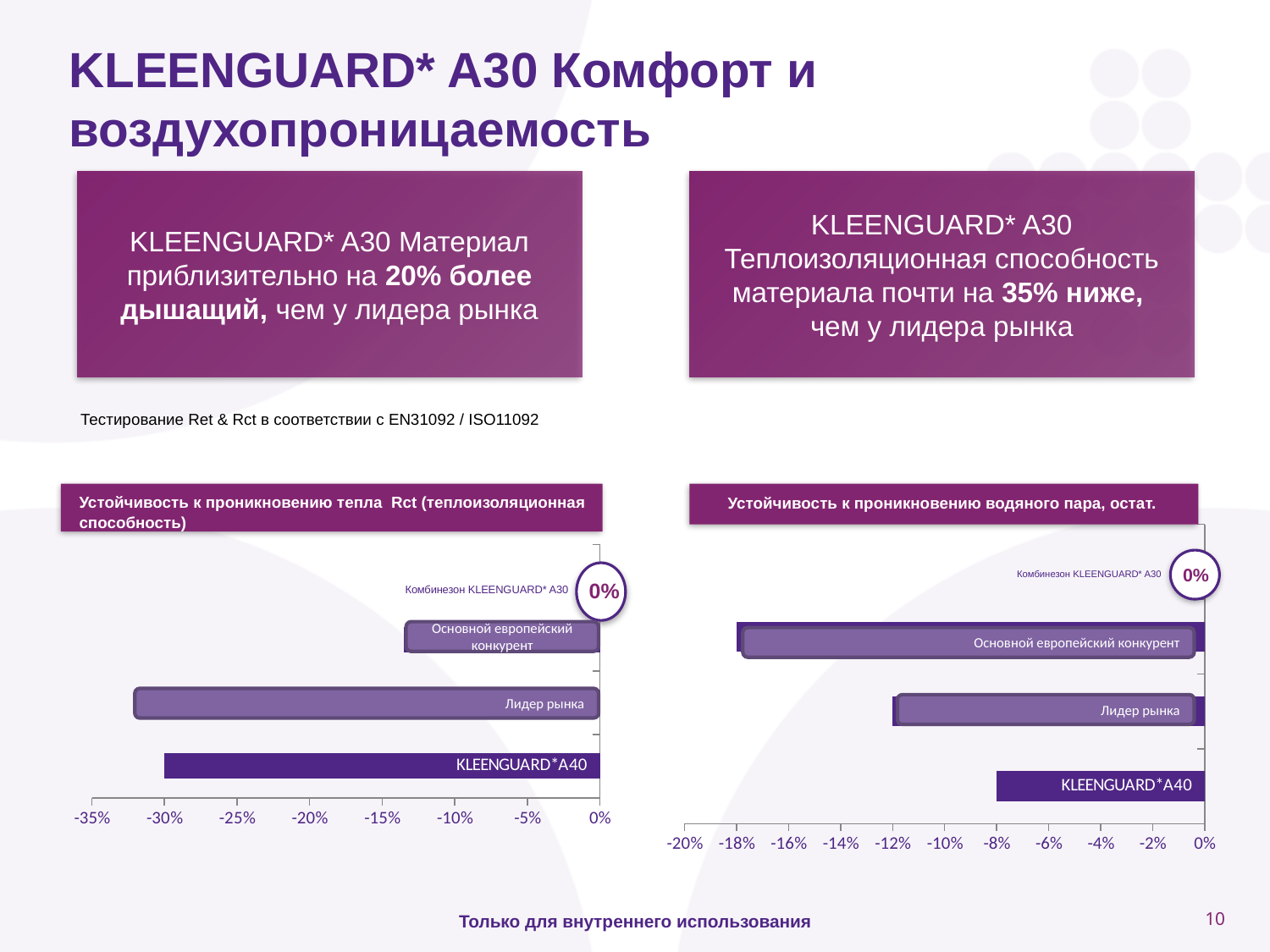
What kind of chart is the left chart titled 'Устойчивость к проникновению тепла Rct'? bar chart How many categories are plotted in the left chart (Устойчивость к проникновению тепла Rct)? 4 What is the title of the right chart? Устойчивость к проникновению водяного пара, остат. In the left chart (Устойчивость к проникновению тепла Rct), what value is shown for Комбинезон KLEENGUARD* A30? 0% How many categories are plotted in the right chart (Устойчивость к проникновению водяного пара)? 4 In the right chart (Устойчивость к проникновению водяного пара), which category has the lowest (most negative) value? Основной европейский конкурент In the left chart (Устойчивость к проникновению тепла Rct), which is larger: the value for Основной европейский конкурент or the value for Лидер рынка? Основной европейский конкурент In the left chart (Устойчивость к проникновению тепла Rct), which category has the highest value? Комбинезон KLEENGUARD* A30 In the right chart (Устойчивость к проникновению водяного пара), is the value for KLEENGUARD*A40 greater or less than -10%? greater In the left chart (Устойчивость к проникновению тепла Rct), is the value for Лидер рынка greater or less than -30%? less In the left chart (Устойчивость к проникновению тепла Rct), is the value for Основной европейский конкурент greater or less than -15%? greater In the right chart (Устойчивость к проникновению водяного пара), what value is shown for Комбинезон KLEENGUARD* A30? 0%